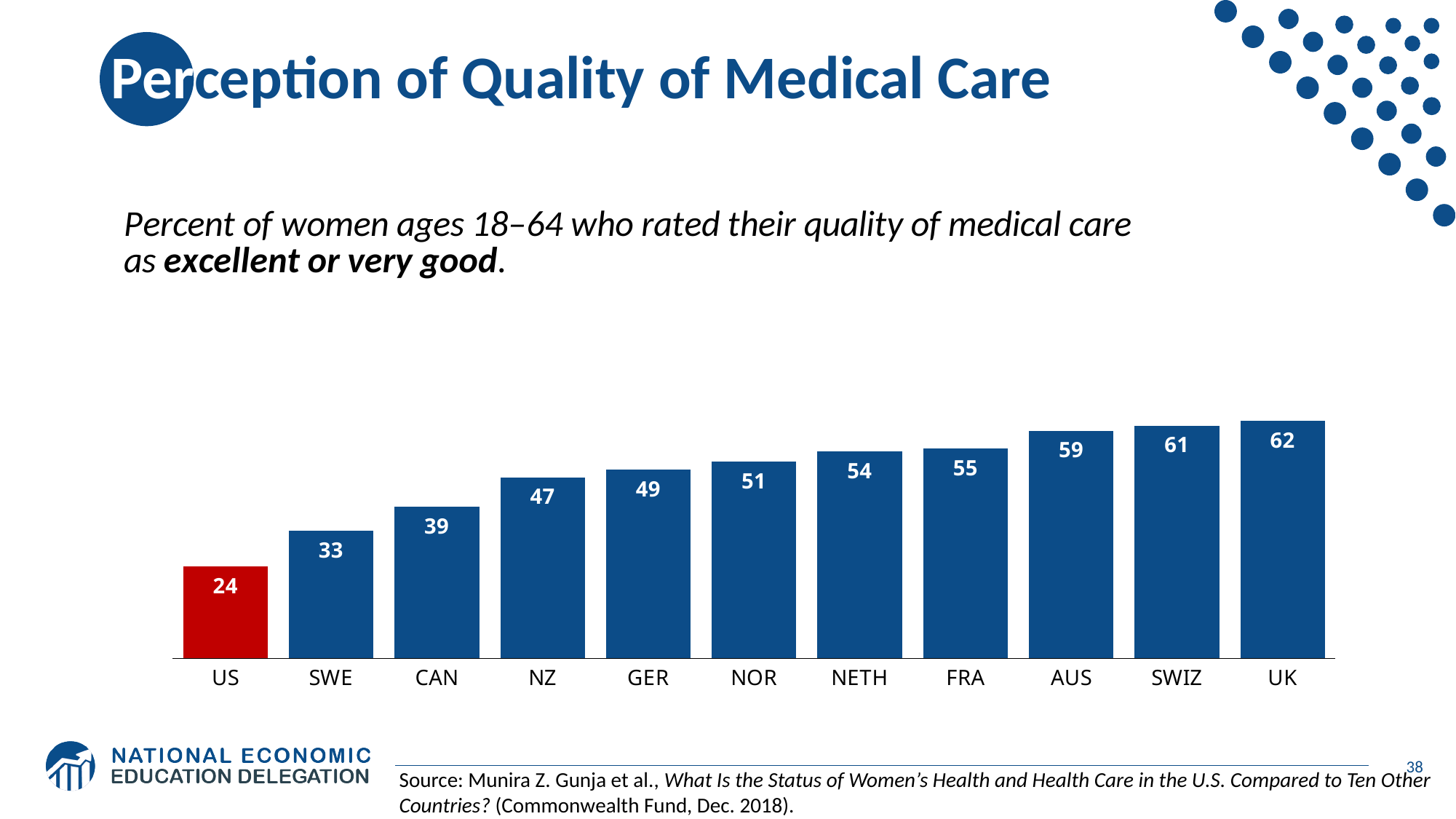
Which country has the lowest value? US What kind of chart is shown on the slide? bar chart What is the value for GER? 49 How many countries are shown in the chart? 11 Do the values rise or fall from left to right along the x axis? rise What is the difference between the values for UK and US? 38 What is the value for the US? 24 What is the difference between the values for CAN and SWE? 6 Which has a larger value, NOR or NZ? NOR Which country has the highest value? UK What is the value for AUS? 59 Which bar is coloured red rather than blue? US